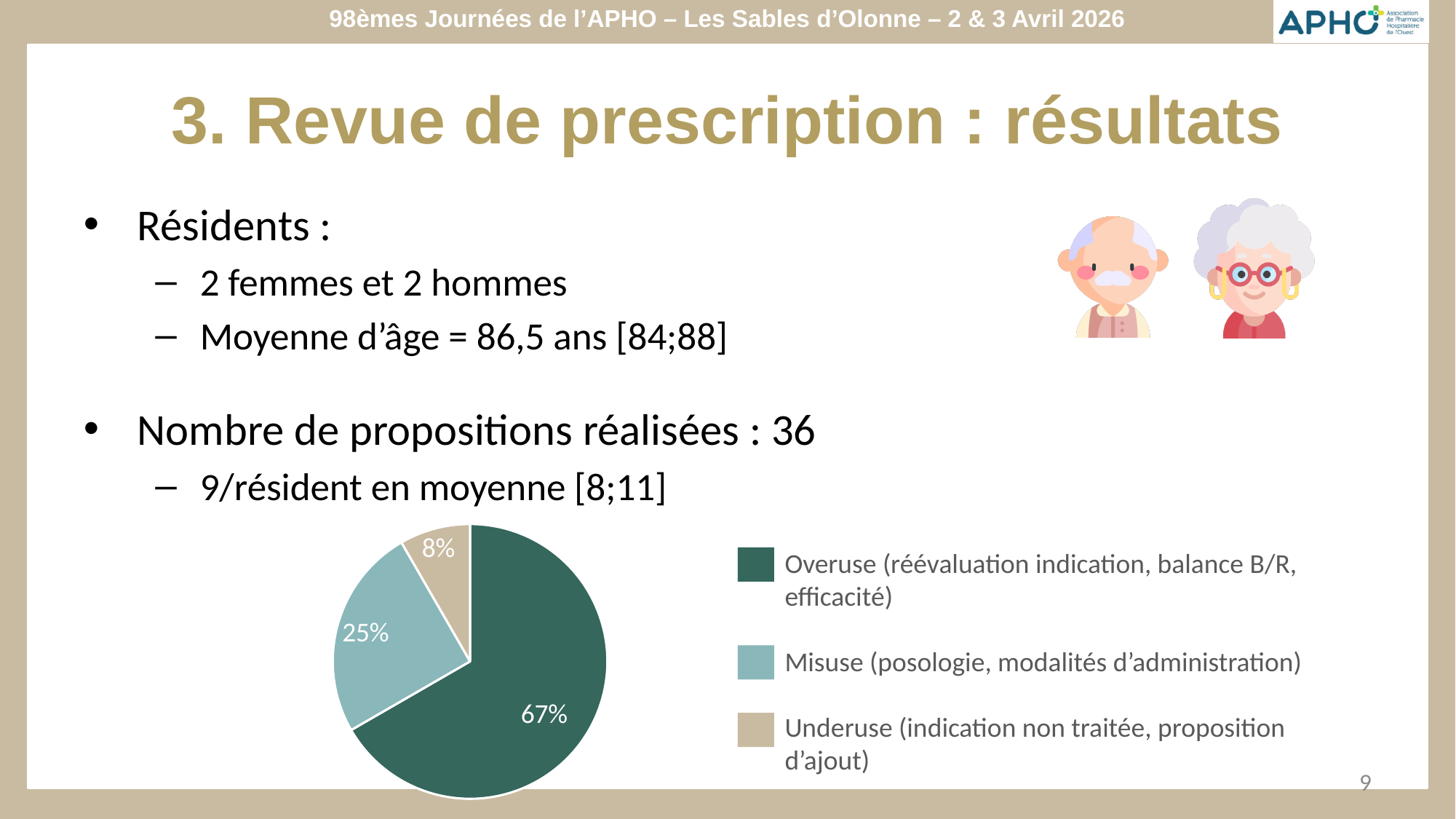
What is the difference in percentage points between the Overuse and Misuse slices? 42 Which slice is larger, Misuse or Underuse? Misuse What kind of chart is shown on the slide? pie chart What is the difference in percentage points between the Misuse and Underuse slices? 17 What share of the pie does Misuse represent? 25% Which category has the smallest slice of the pie? Underuse How many slices does the pie chart have? 3 What share of the pie does Overuse represent? 67% Which category has the largest slice of the pie? Overuse What colour is the Overuse slice in the pie chart? dark green What share of the pie does Underuse represent? 8% How many entries does the legend of the pie chart list? 3